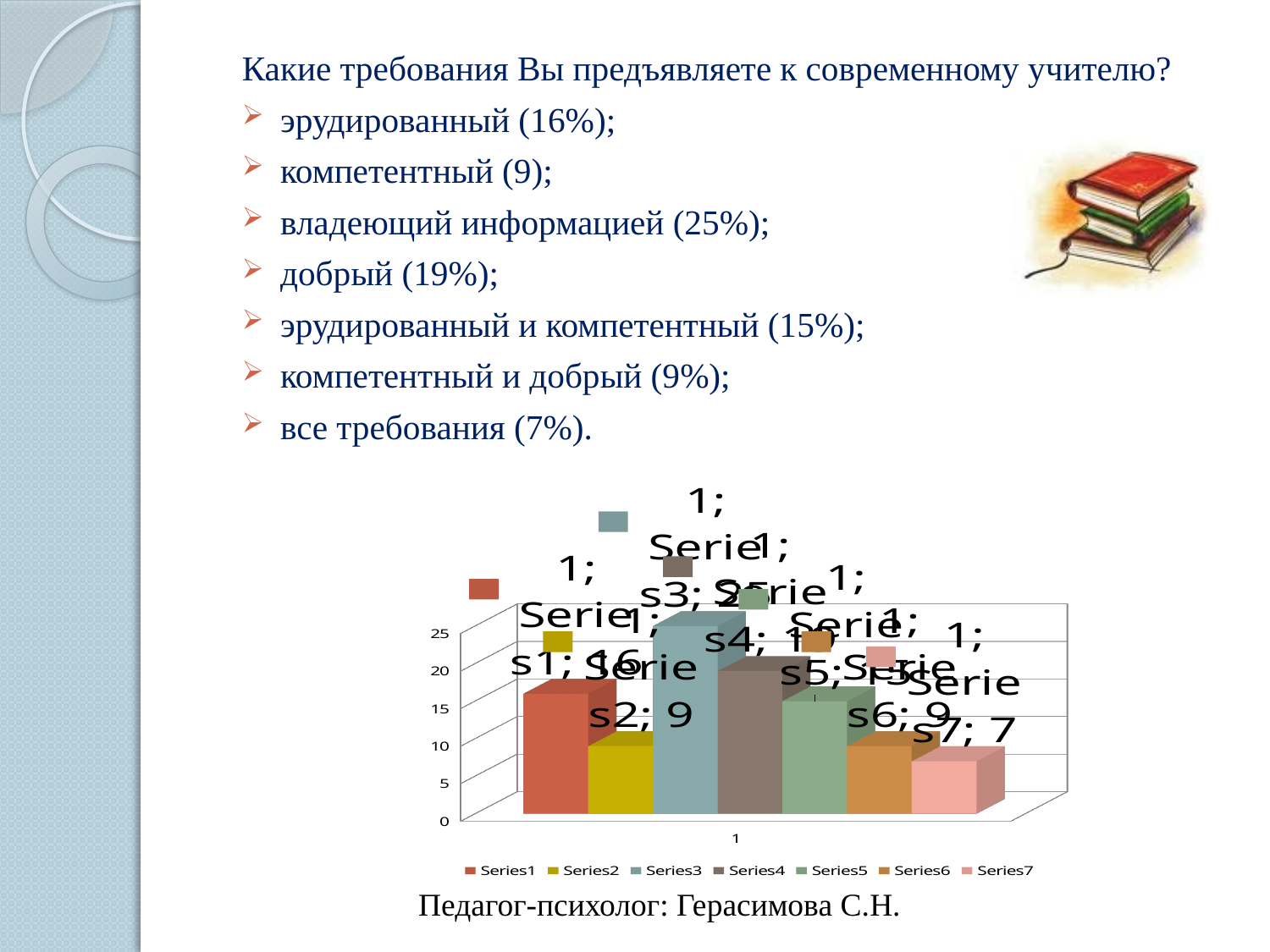
What is the value for Series2 in the chart? 9 What is the value for Series7 in the chart? 7 Which series has the shortest bar in the chart? Series7 What type of chart is shown on the slide? bar chart Is the value for Series3 greater or less than 20? greater What is the difference between the values for Series1 and Series2? 7 What is the value for Series6 in the chart? 9 Is the value for Series5 greater or less than 20? less Which series has the tallest bar in the chart? Series3 Which is larger, the value for Series1 or the value for Series2? Series1 How many series does the chart legend list? 7 What is the value for Series1 in the chart? 16